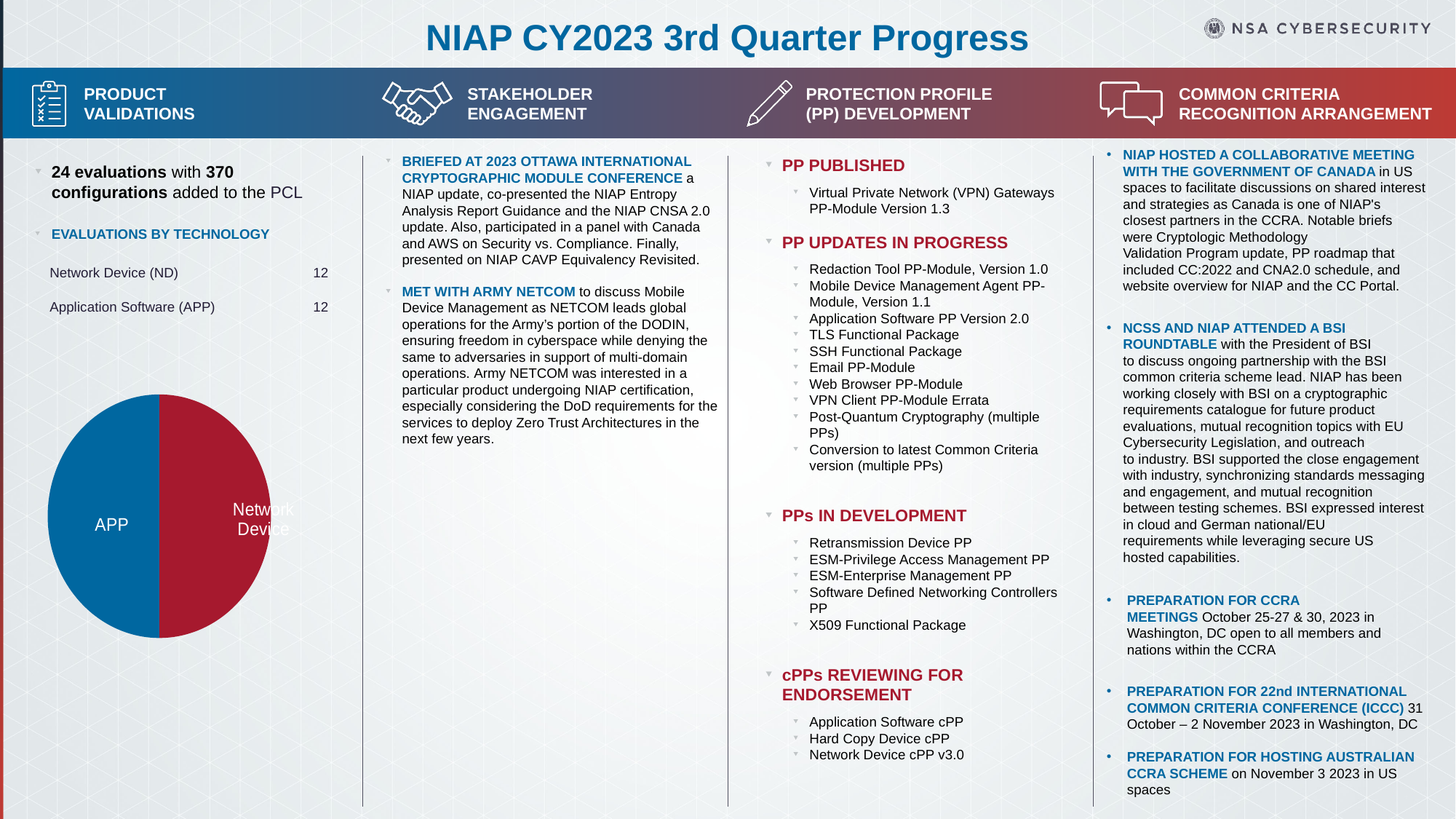
What share of the pie does the APP slice represent? 50% What colour is the APP slice of the pie chart? blue What are the two categories labelled on the pie chart? APP and Network Device What kind of chart is shown on the slide? pie chart According to the Evaluations by Technology table that the pie chart plots, how many evaluations were for Application Software (APP)? 12 What share of the pie does the Network Device slice represent? 50% Is the Network Device slice larger than, smaller than, or equal to the APP slice? equal According to the Evaluations by Technology table that the pie chart plots, how many evaluations were for Network Device (ND)? 12 How many slices does the pie chart have? 2